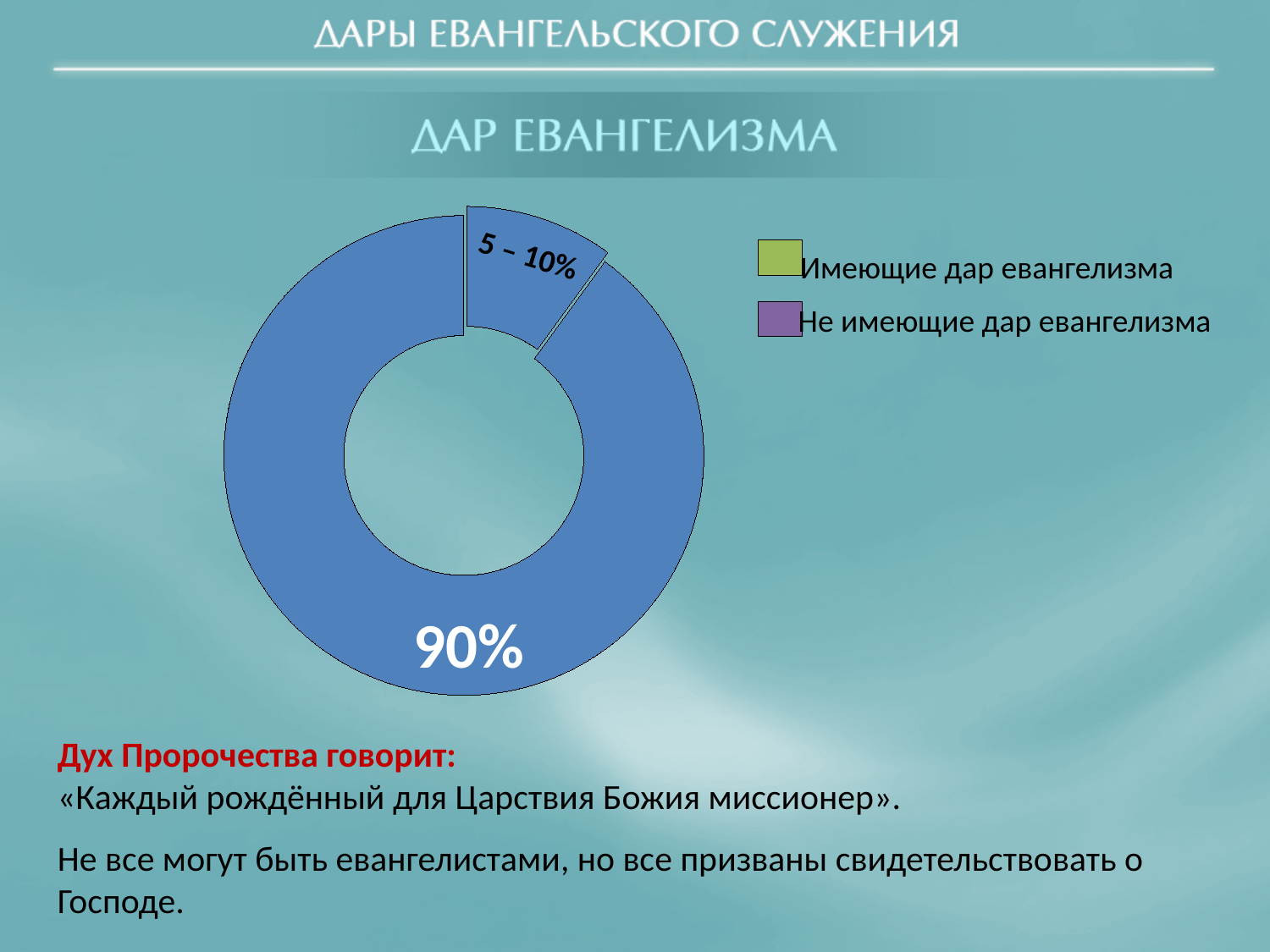
How many slices does the chart have? 2 Which slice is the smallest in the chart? the slice labelled 5 – 10% What is the title shown directly above the chart? ДАР ЕВАНГЕЛИЗМА What are the two legend entries of the chart? Имеющие дар евангелизма; Не имеющие дар евангелизма Which slice is the largest in the chart? the slice labelled 90% What kind of chart is shown on the slide? pie chart (doughnut) What value is printed on the large slice of the chart? 90% How many entries does the legend list? 2 What label is printed on the small slice of the chart? 5 – 10% Which is larger: the slice labelled 90% or the slice labelled 5 – 10%? the slice labelled 90%